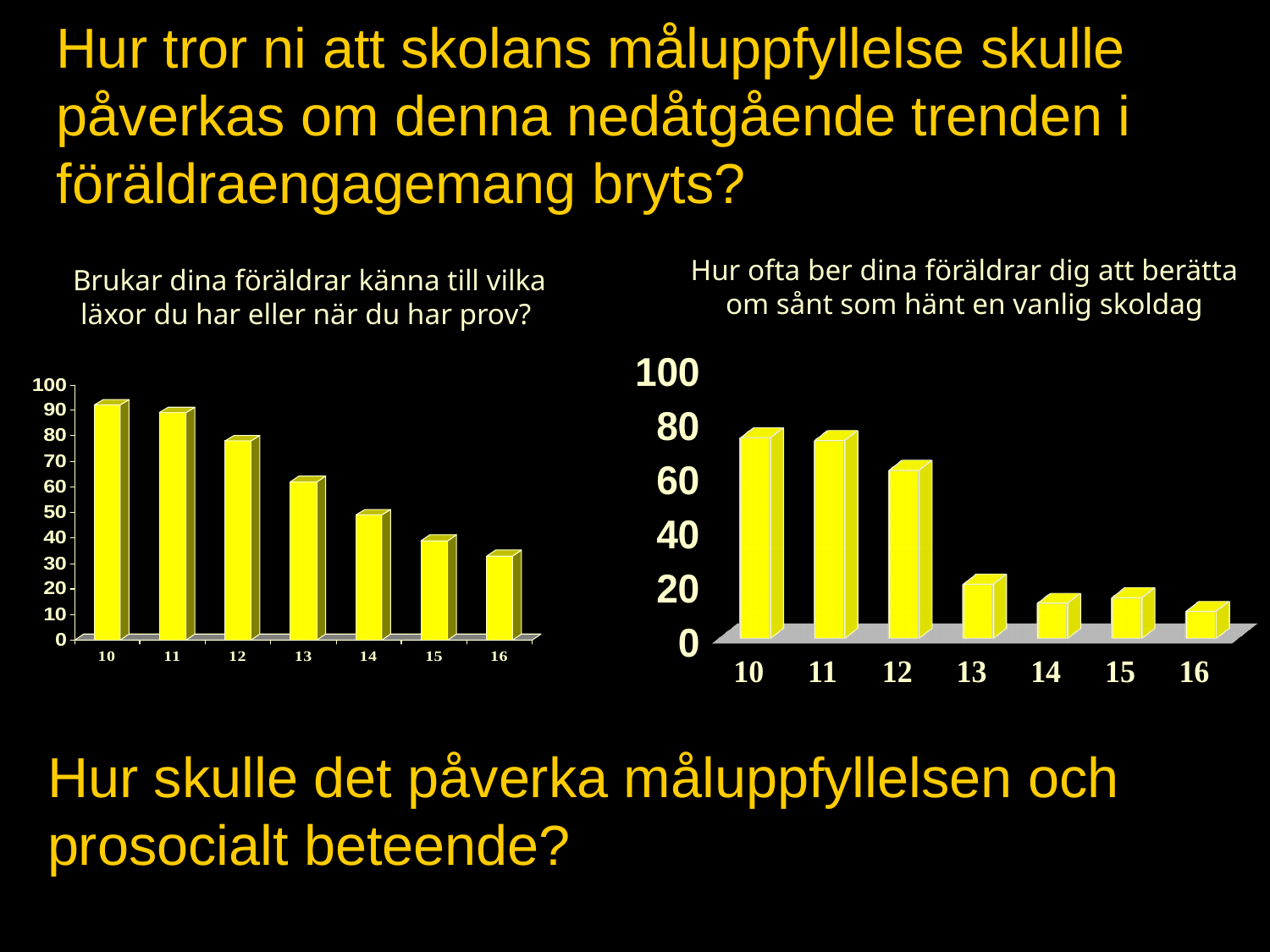
In the right chart, 'Hur ofta ber dina föräldrar dig att berätta om sånt som hänt en vanlig skoldag', which category has the lowest value? 16 In the left chart, 'Brukar dina föräldrar känna till vilka läxor du har eller när du har prov?', is the value for 14 greater or less than 40? greater How many categories are shown on the x axis of the right chart, 'Hur ofta ber dina föräldrar dig att berätta om sånt som hänt en vanlig skoldag'? 7 In the left chart, 'Brukar dina föräldrar känna till vilka läxor du har eller när du har prov?', which category has the lowest value? 16 What is the highest tick value shown on the y axis of the right chart, 'Hur ofta ber dina föräldrar dig att berätta om sånt som hänt en vanlig skoldag'? 100 In the right chart, 'Hur ofta ber dina föräldrar dig att berätta om sånt som hänt en vanlig skoldag', which is larger, the value for 12 or the value for 13? 12 What kind of chart is the left chart, 'Brukar dina föräldrar känna till vilka läxor du har eller när du har prov?'? bar chart In the left chart, 'Brukar dina föräldrar känna till vilka läxor du har eller när du har prov?', which is larger, the value for 12 or the value for 15? 12 In the left chart, 'Brukar dina föräldrar känna till vilka läxor du har eller när du har prov?', do the values rise or fall as the age increases from 10 to 16? fall In the right chart, 'Hur ofta ber dina föräldrar dig att berätta om sånt som hänt en vanlig skoldag', is the value for 16 greater or less than 20? less In the left chart, 'Brukar dina föräldrar känna till vilka läxor du har eller när du har prov?', is the value for 11 greater or less than 80? greater